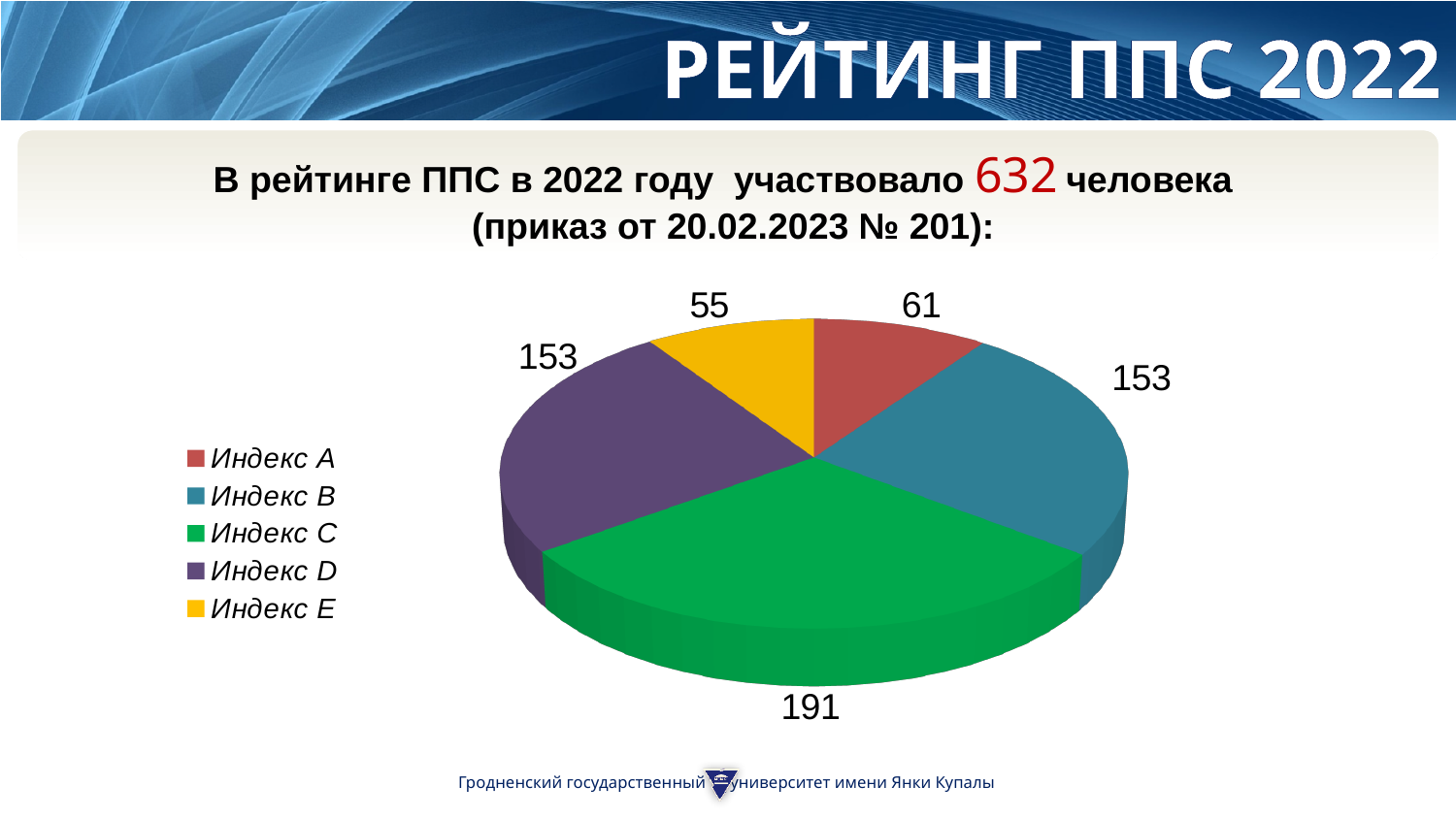
What colour is the slice for Индекс D? Purple Which category has the smallest slice? Индекс E What type of chart is shown on the slide? Pie chart Which category has the largest slice? Индекс C What is the value for Индекс E? 55 How many slices does the pie chart have? 5 What is the value for Индекс B? 153 Which is larger, the value for Индекс A or Индекс E? Индекс A What is the value for Индекс C? 191 How many entries does the legend list? 5 What is the difference between the values for Индекс C and Индекс A? 130 What is the value for Индекс A? 61